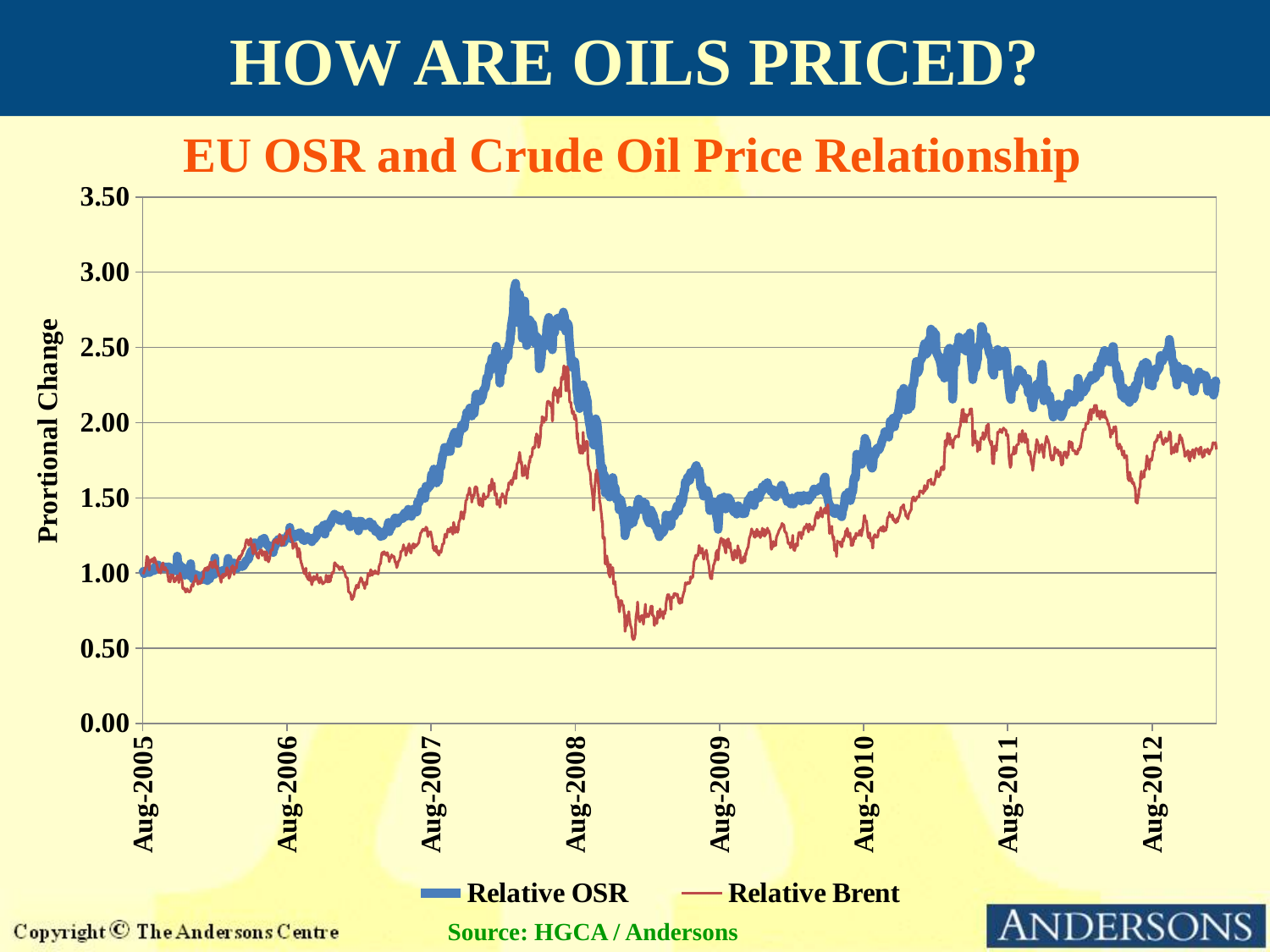
Which series reaches the highest value anywhere on the chart? Relative OSR How many series does the legend list? 2 What kind of chart is shown on the slide? Line chart Does the Relative OSR line rise or fall between Aug-2005 and Aug-2007? Rise Is the value of Relative OSR at Aug-2012 greater or less than 2.00? greater How many year labels are shown on the x axis? 8 What is the title of the chart? EU OSR and Crude Oil Price Relationship Is the lowest value of Relative Brent in late 2008 greater or less than 1.00? less What are the two series named in the legend? Relative OSR and Relative Brent Is the peak value of Relative OSR around early 2008 greater or less than 2.50? greater At Aug-2012, which series has the higher value, Relative OSR or Relative Brent? Relative OSR